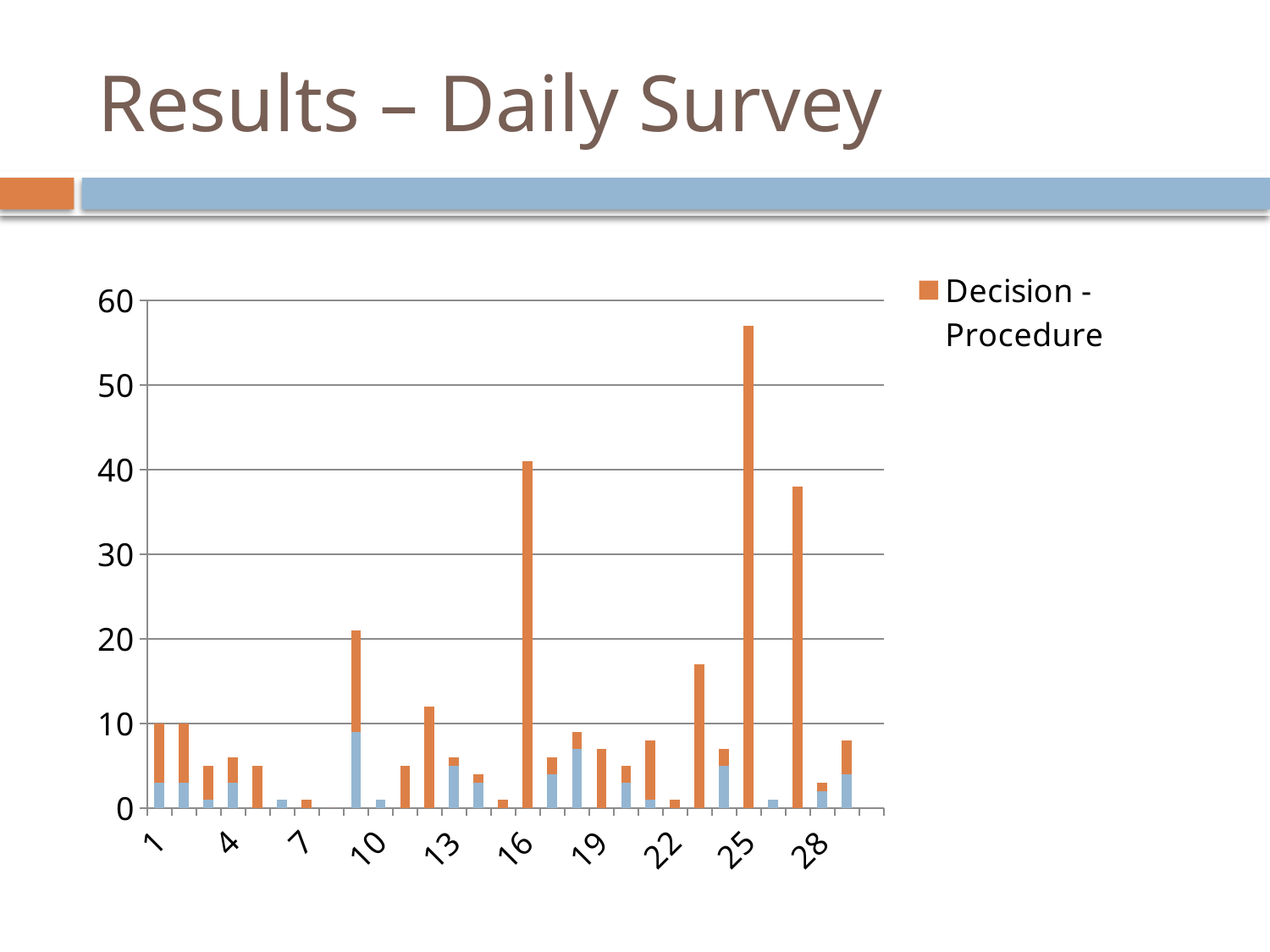
How many series does the legend list? 1 What is the name of the series shown in the legend? Decision - Procedure Is the value for 28 greater or less than 10? less What colour is used for the Decision - Procedure series? orange Which is larger, the value for 4 or the value for 7? 4 Which x-axis label has the tallest bar? 25 Is the value for 22 greater or less than 10? less What kind of chart is shown on the slide? bar chart Is the value for 25 greater or less than 50? greater Which is larger, the value for 16 or the value for 25? 25